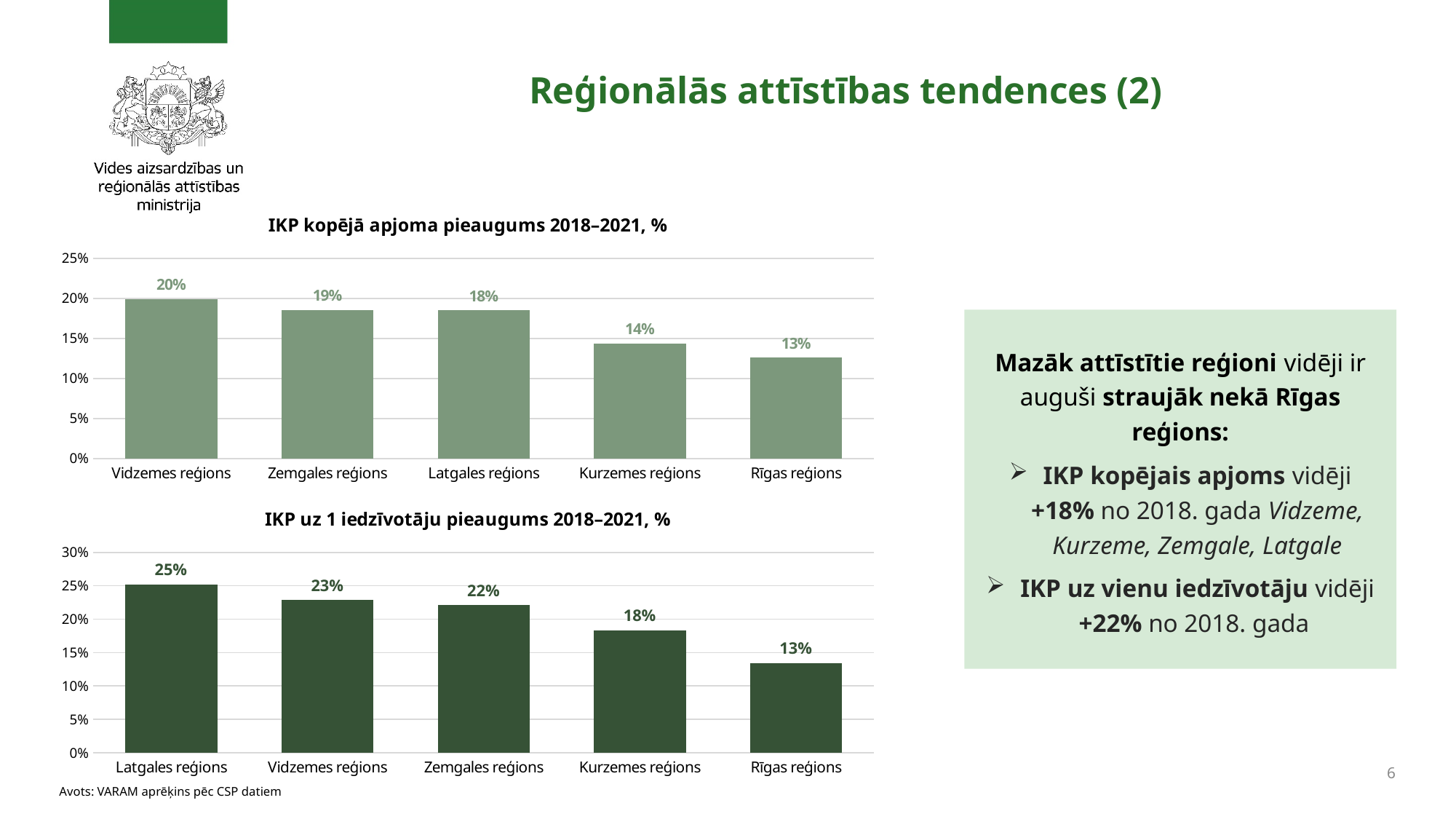
In the chart titled 'IKP kopējā apjoma pieaugums 2018–2021, %', what is the value for Vidzemes reģions? 20% What kind of chart is the chart titled 'IKP uz 1 iedzīvotāju pieaugums 2018–2021, %'? Bar chart In the chart titled 'IKP uz 1 iedzīvotāju pieaugums 2018–2021, %', what is the value for Latgales reģions? 25% In the chart titled 'IKP kopējā apjoma pieaugums 2018–2021, %', what is the difference between Vidzemes reģions and Rīgas reģions? 7% In the chart titled 'IKP kopējā apjoma pieaugums 2018–2021, %', do the values rise or fall from left to right? Fall In the chart titled 'IKP uz 1 iedzīvotāju pieaugums 2018–2021, %', which is larger: Vidzemes reģions or Kurzemes reģions? Vidzemes reģions In the chart titled 'IKP uz 1 iedzīvotāju pieaugums 2018–2021, %', what is the difference between Latgales reģions and Rīgas reģions? 12% In the chart titled 'IKP kopējā apjoma pieaugums 2018–2021, %', how many regions are shown? 5 In the chart titled 'IKP kopējā apjoma pieaugums 2018–2021, %', what is the value for Kurzemes reģions? 14% In the chart titled 'IKP uz 1 iedzīvotāju pieaugums 2018–2021, %', which region has the highest value? Latgales reģions In the chart titled 'IKP kopējā apjoma pieaugums 2018–2021, %', which region has the lowest value? Rīgas reģions In the chart titled 'IKP uz 1 iedzīvotāju pieaugums 2018–2021, %', what is the value for Zemgales reģions? 22%